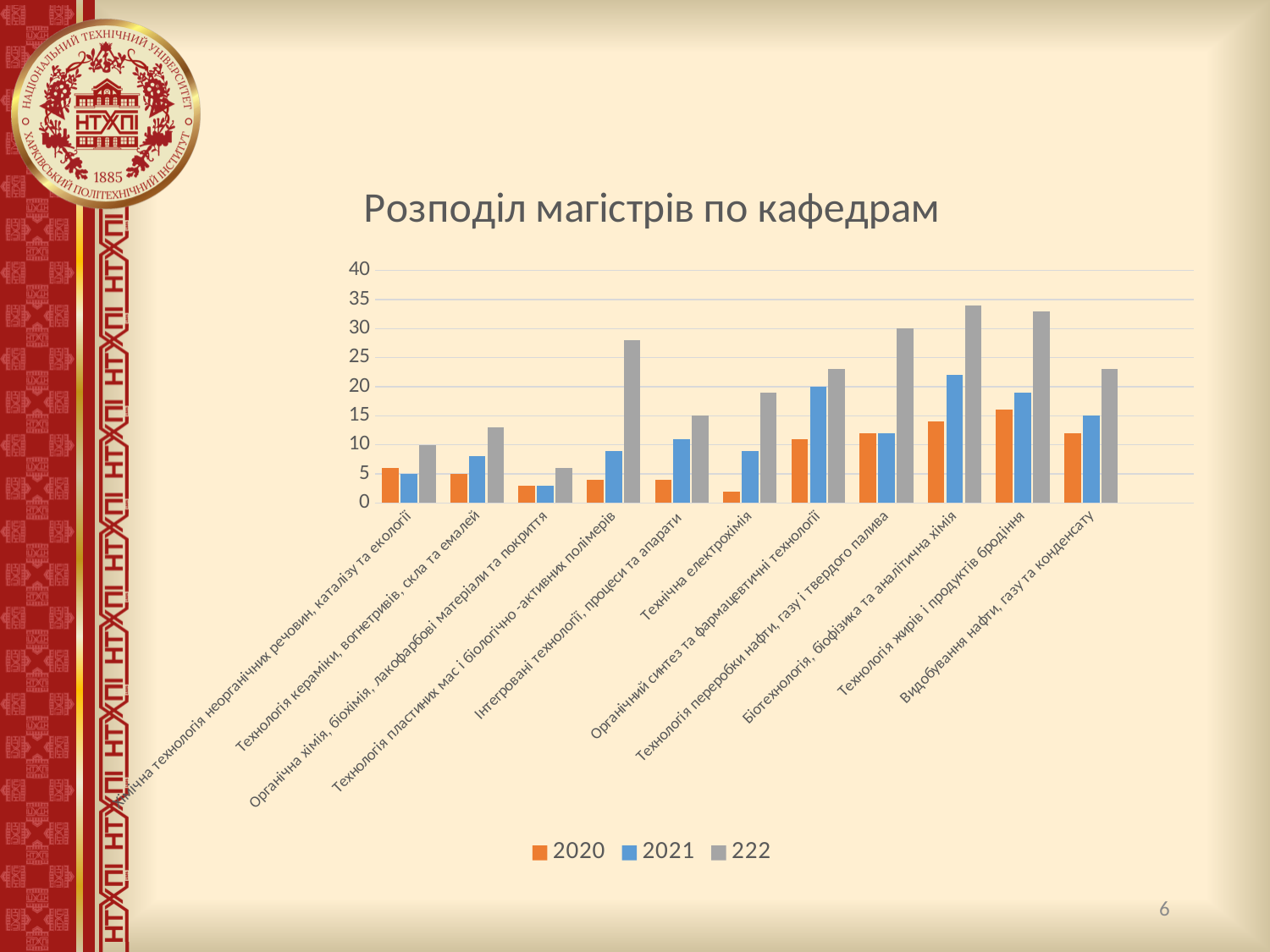
What type of chart is shown on the slide? bar chart How many departments (categories) are shown on the x axis? 11 For Органічний синтез та фармацевтичні технології, which series is larger: 2020 or 2021? 2021 What is the title of the chart? Розподіл магістрів по кафедрам Which department has the lowest value in the 222 series? Органічна хімія, біохімія, лакофарбові матеріали та покриття Which department has the highest value in the 2020 series? Технологія жирів і продуктів бродіння Is the value of the 222 series for Технологія пластичних мас і біологічно-активних полімерів greater or less than 25? greater Is the value of the 2020 series for Технічна електрохімія greater or less than 5? less How many series does the legend list? 3 Is the value of the 2021 series for Біотехнологія, біофізика та аналітична хімія greater or less than 20? greater What are the legend entries of the chart? 2020, 2021, 222